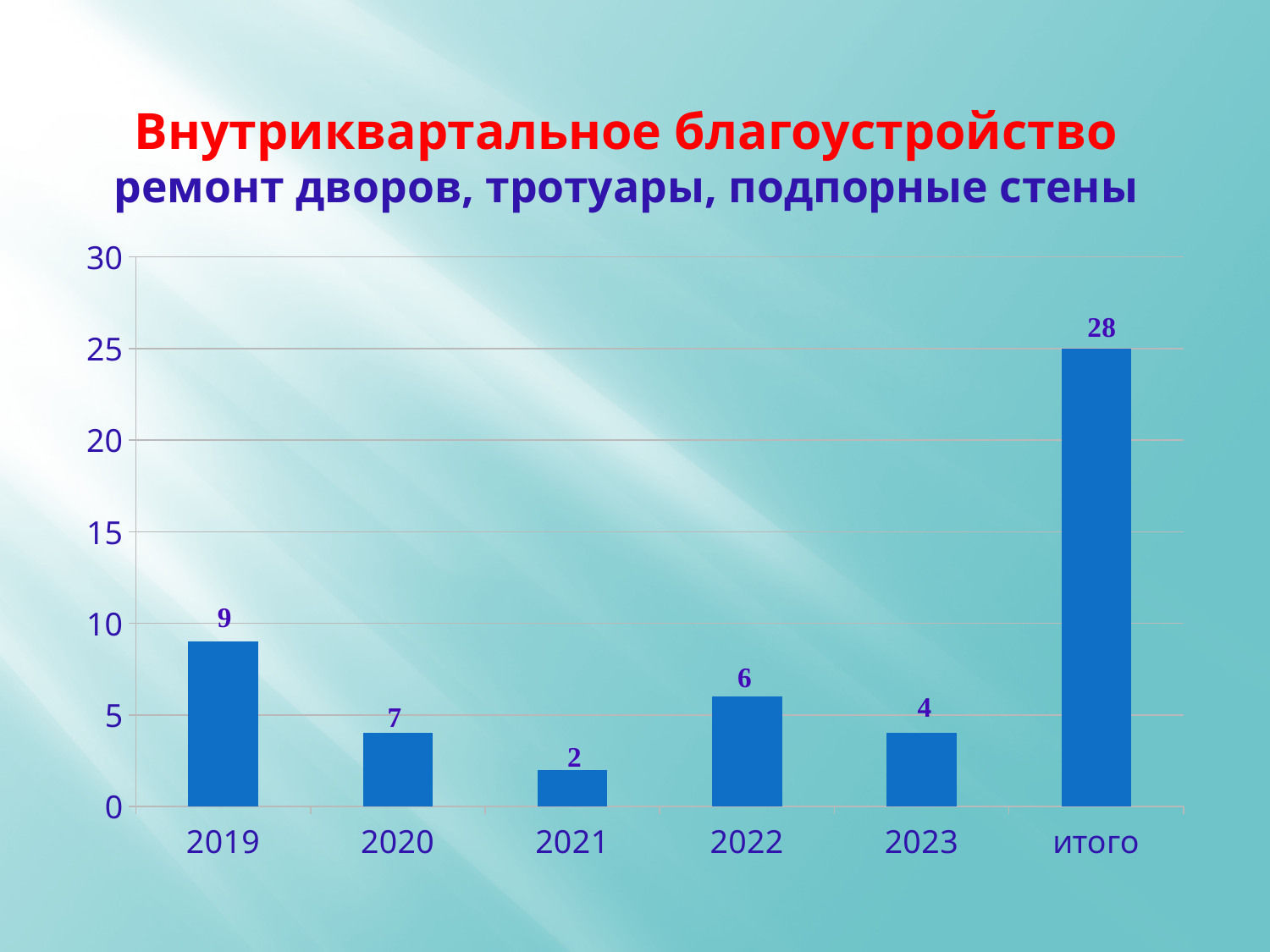
What is the value for 2023? 4 What is the value for 2021? 2 What is the difference between the values for 2019 and 2021? 7 Is the value for "итого" greater or less than 20? greater What is the value for 2019? 9 Among the years 2019 to 2023, which year has the lowest value? 2021 Which is larger, the value for 2022 or the value for 2021? 2022 What is the value for 2022? 6 What kind of chart is shown on the slide? Bar chart Among the years 2019 to 2023, which year has the highest value? 2019 What is the value shown for the "итого" bar? 28 How many bars are shown in the chart? 6